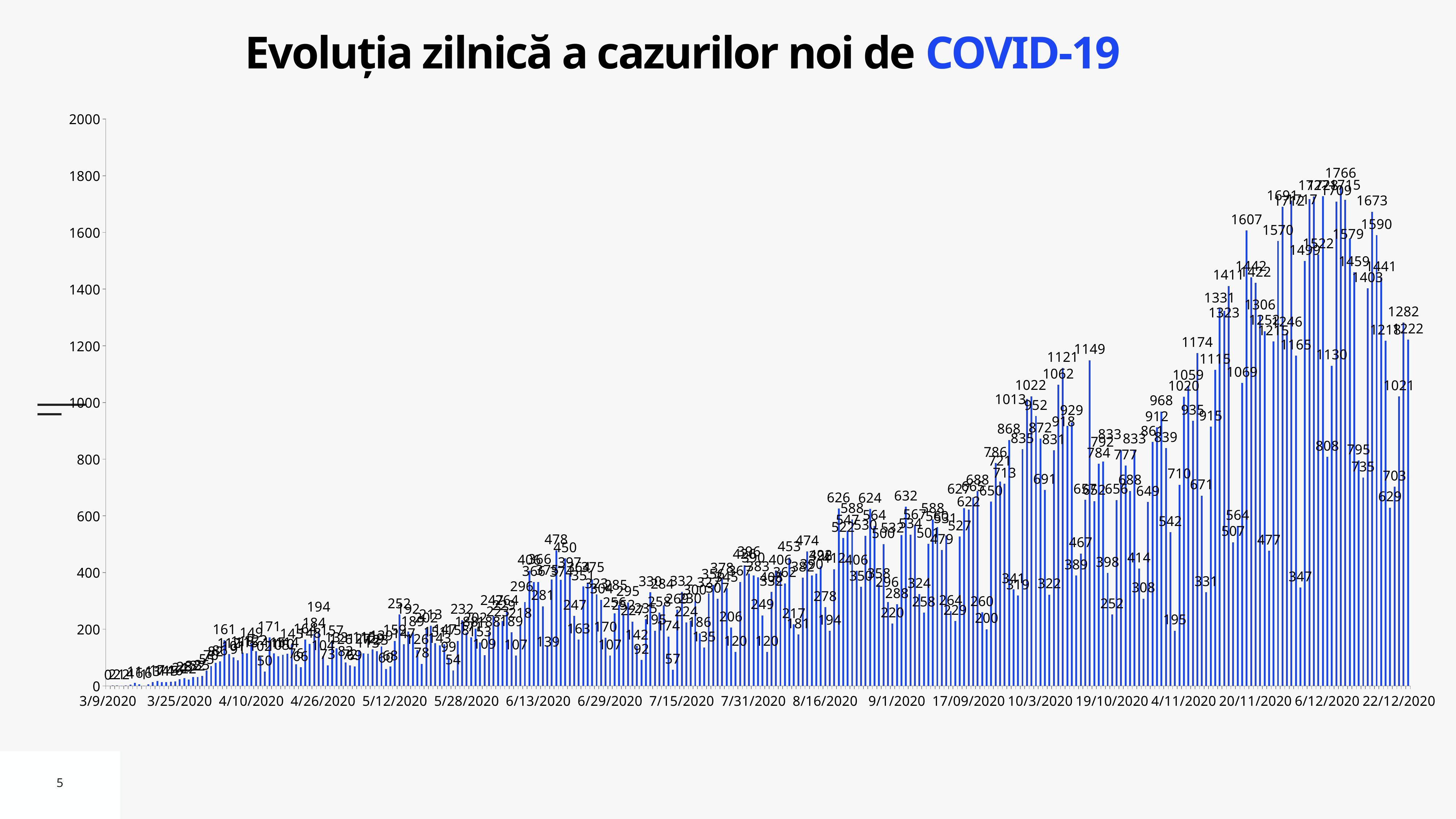
What is the highest value labeled on the chart? 1766 What is the title of the chart? Evoluția zilnică a cazurilor noi de COVID-19 Overall, do the daily values rise or fall from March 2020 to December 2020? rise What is the difference between the labeled values 1766 and 1673? 93 Which is larger, the labeled value 478 or the labeled value 450? 478 Is the value for 3/25/2020 greater or less than 200? less What is the highest tick value shown on the vertical axis? 2000 Which is larger, the labeled value 626 or the labeled value 632? 632 Is the value for 22/12/2020 greater or less than 1000? greater What is the last date label shown on the horizontal axis? 22/12/2020 What kind of chart is shown on the slide? bar chart What is the value labeled for the first date, 3/9/2020? 0